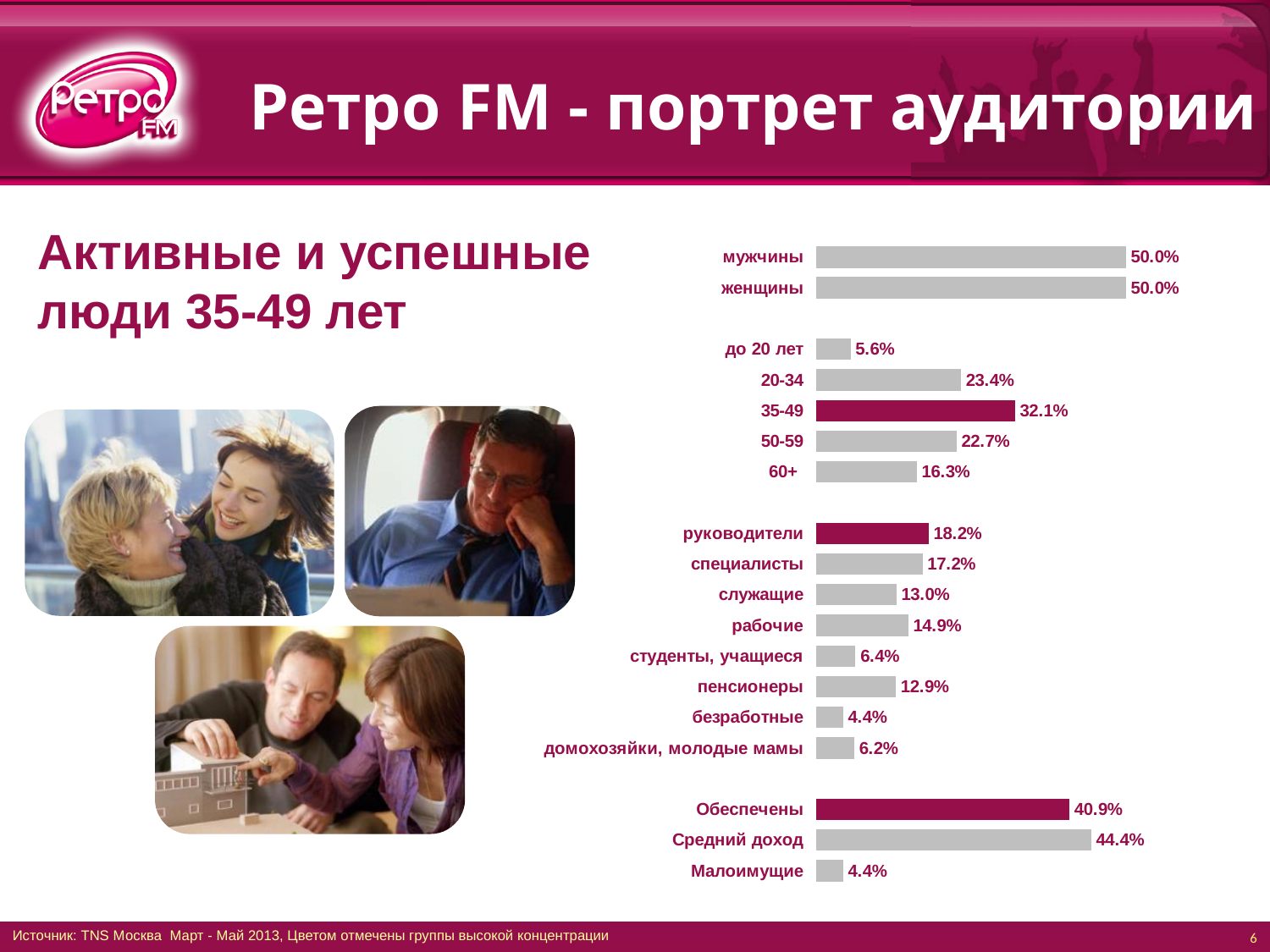
What is the difference between the values for руководители and специалисты? 1.0% Which occupation category has the lowest value? безработные How many occupation categories are shown, from руководители to домохозяйки, молодые мамы? 8 Which age group has the lowest value? до 20 лет What is the difference between the values for Средний доход and Обеспечены? 3.5% Which age group has the highest value? 35-49 What kind of chart is shown on the slide? bar chart What is the value for the 35-49 age group? 32.1% Which three bars are highlighted in dark red rather than grey? 35-49, руководители, Обеспечены What is the value for руководители? 18.2% Which is larger, the value for 20-34 or the value for 50-59? 20-34 What is the value for Малоимущие? 4.4%